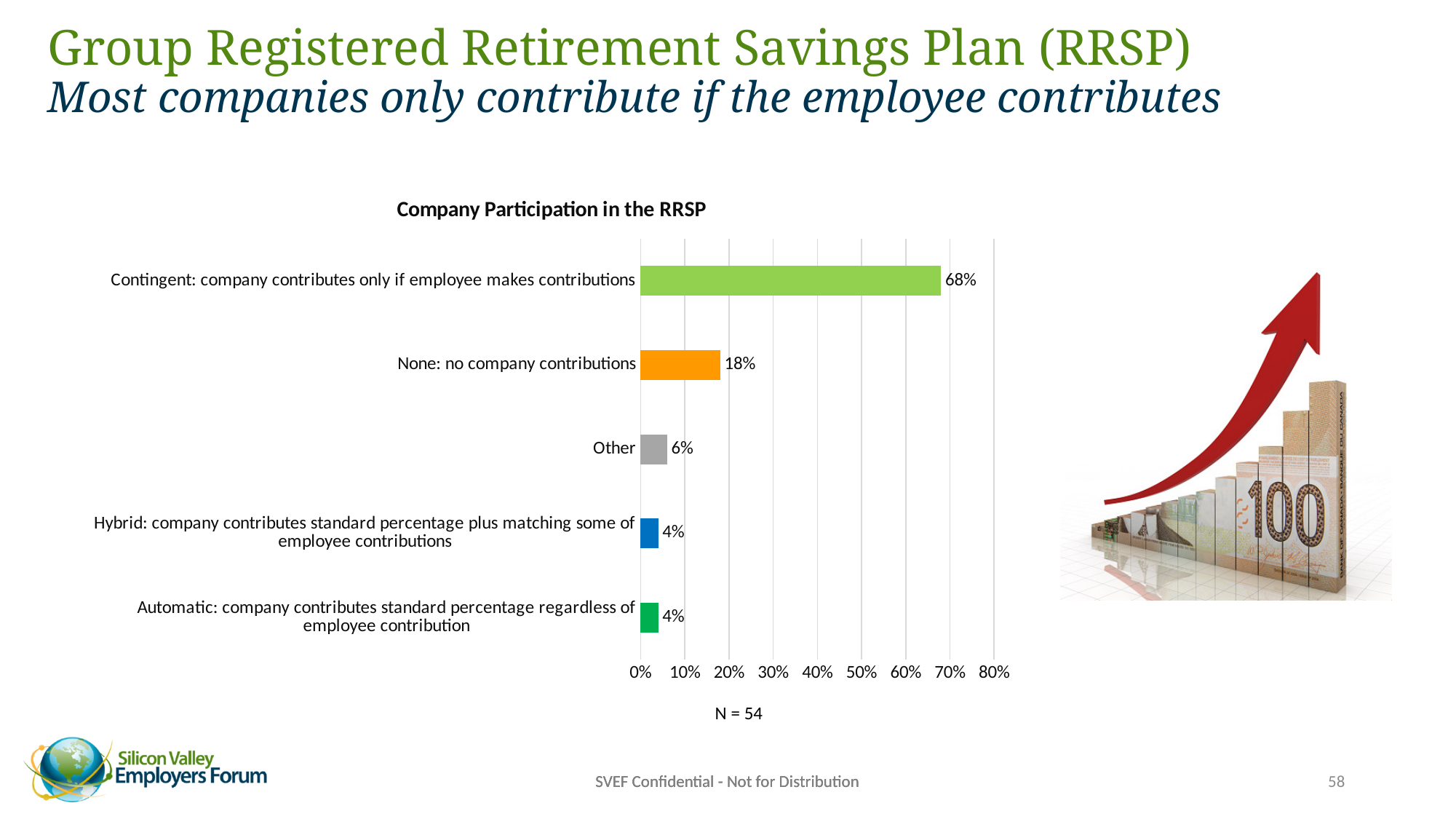
Is the value for 'Contingent: company contributes only if employee makes contributions' greater or less than 60%? greater What is the difference between the 'None' value and the 'Other' value? 12% What is the title of the chart? Company Participation in the RRSP What is the value for 'None: no company contributions'? 18% What is the value for 'Other'? 6% How many categories are shown in the chart? 5 What is the difference between the 'Contingent' value and the 'None' value? 50% What is the value for 'Contingent: company contributes only if employee makes contributions'? 68% What is the value for 'Automatic: company contributes standard percentage regardless of employee contribution'? 4% Which category has the highest value? Contingent: company contributes only if employee makes contributions Which is larger, the value for 'None: no company contributions' or the value for 'Other'? None: no company contributions What kind of chart is shown on the slide? bar chart